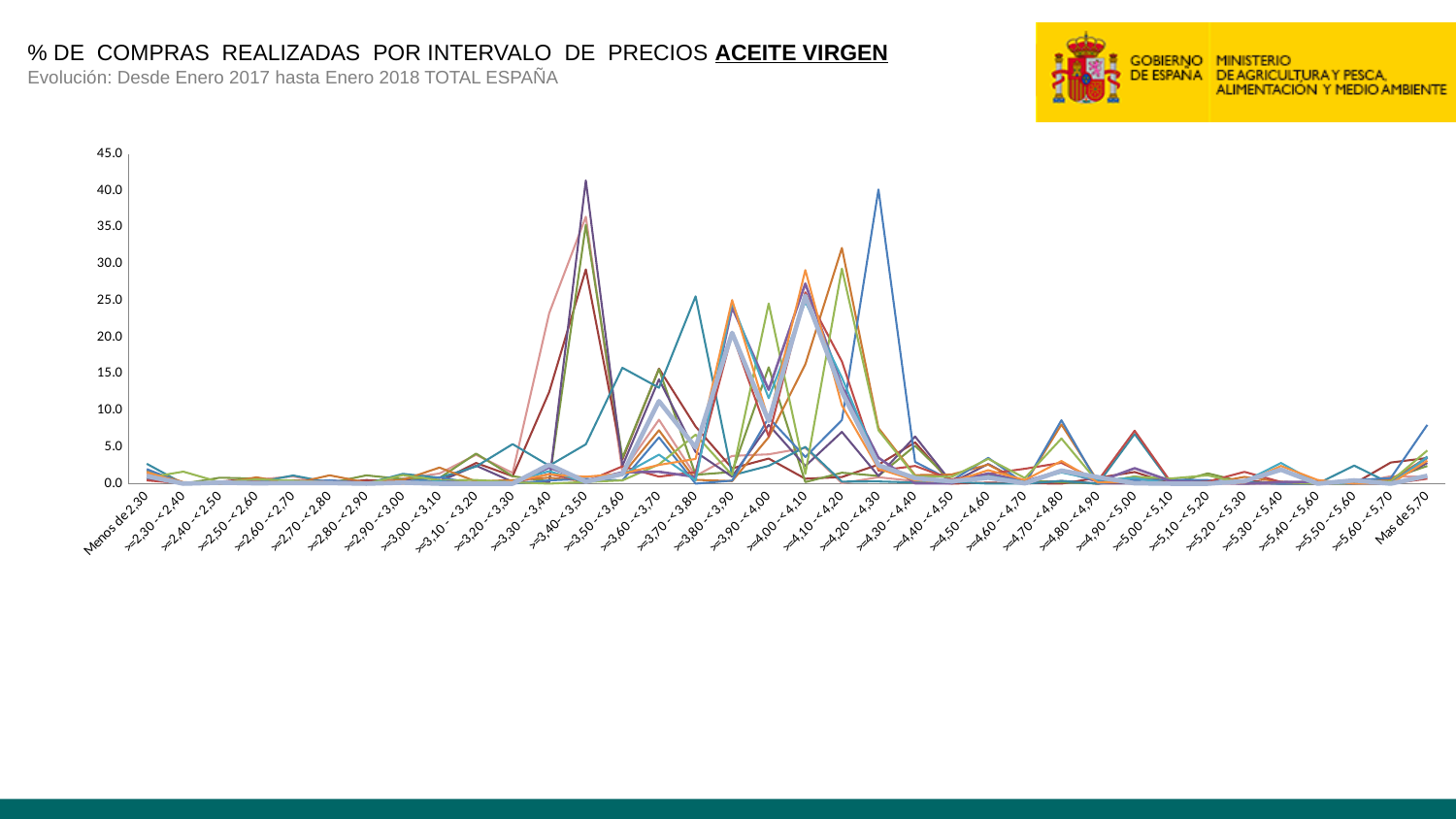
What is the highest value shown on the y-axis of the chart? 45.0 What is the last category on the x-axis of the chart? Mas de 5,70 How many price-interval categories are shown on the x-axis of the chart? 36 Is the highest point plotted on the chart greater or less than 35.0? greater Are all the values plotted for the category '>=5,10 - <5,20' greater or less than 5.0? less What is the title of the chart on the slide? % DE COMPRAS REALIZADAS POR INTERVALO DE PRECIOS ACEITE VIRGEN Are all the values plotted for the category 'Menos de 2,30' greater or less than 5.0? less What kind of chart is shown on the slide? line chart What is the first category on the x-axis of the chart? Menos de 2,30 What period does the subtitle say the chart covers? Desde Enero 2017 hasta Enero 2018 TOTAL ESPAÑA What is the step between consecutive tick marks on the y-axis of the chart? 5.0